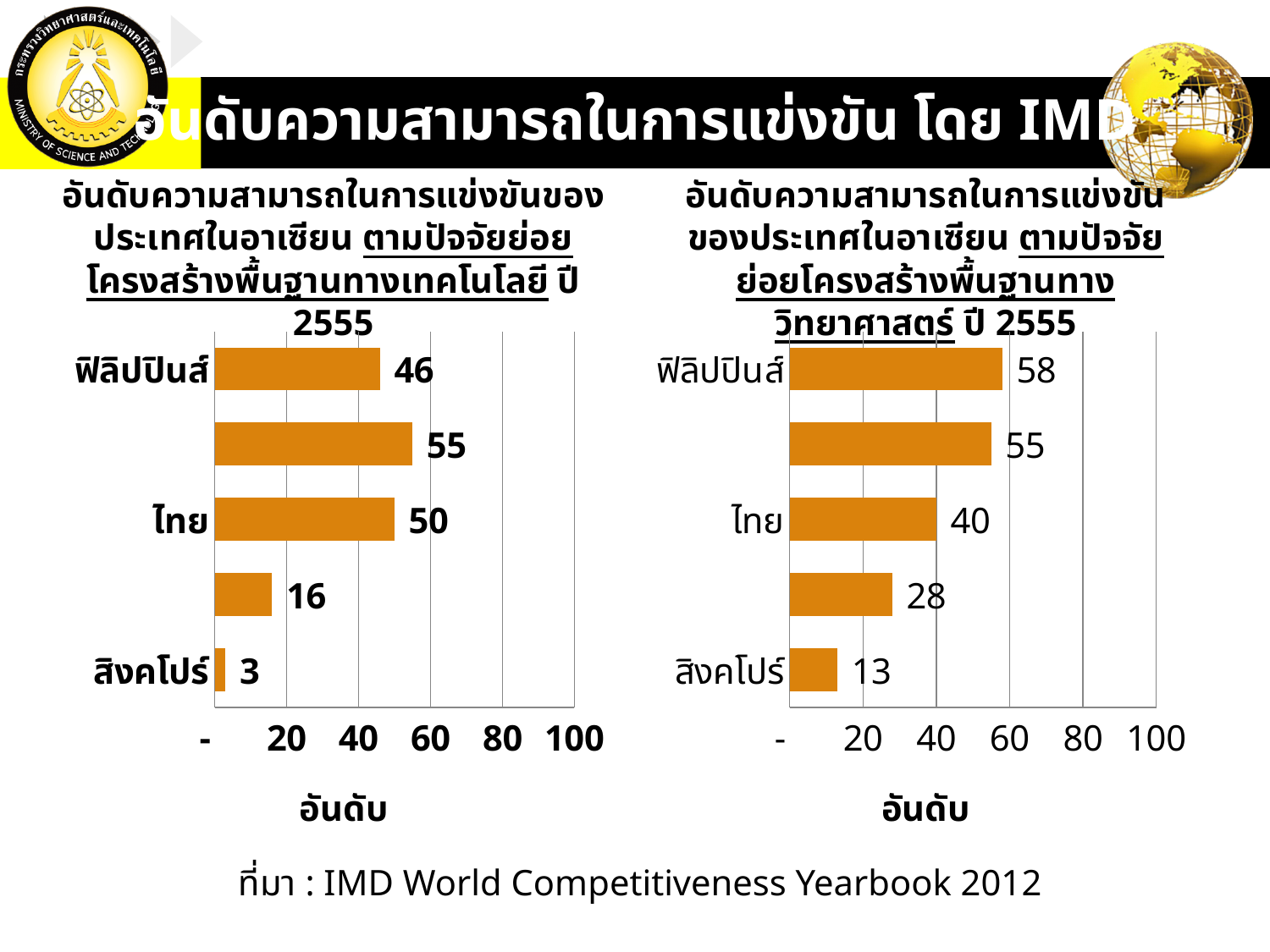
In the right chart (science infrastructure ranking), which country has the highest value? ฟิลิปปินส์ How many bars are plotted in the right chart (science infrastructure ranking)? 5 In the right chart (science infrastructure ranking), what is the value for ฟิลิปปินส์? 58 What type of chart is the left chart (technology infrastructure ranking)? Bar chart In the right chart (science infrastructure ranking), what is the value for สิงคโปร์? 13 In the right chart (science infrastructure ranking), what is the value for ไทย? 40 In the left chart (technology infrastructure ranking), what is the value for ฟิลิปปินส์? 46 In the left chart (technology infrastructure ranking), what is the value for ไทย? 50 In the left chart (technology infrastructure ranking), what is the value for สิงคโปร์? 3 In the right chart (science infrastructure ranking), which is larger, the value for ฟิลิปปินส์ or the value for ไทย? ฟิลิปปินส์ In the left chart (technology infrastructure ranking), what is the difference between the values for ไทย and ฟิลิปปินส์? 4 In the left chart (technology infrastructure ranking), which country has the lowest value? สิงคโปร์